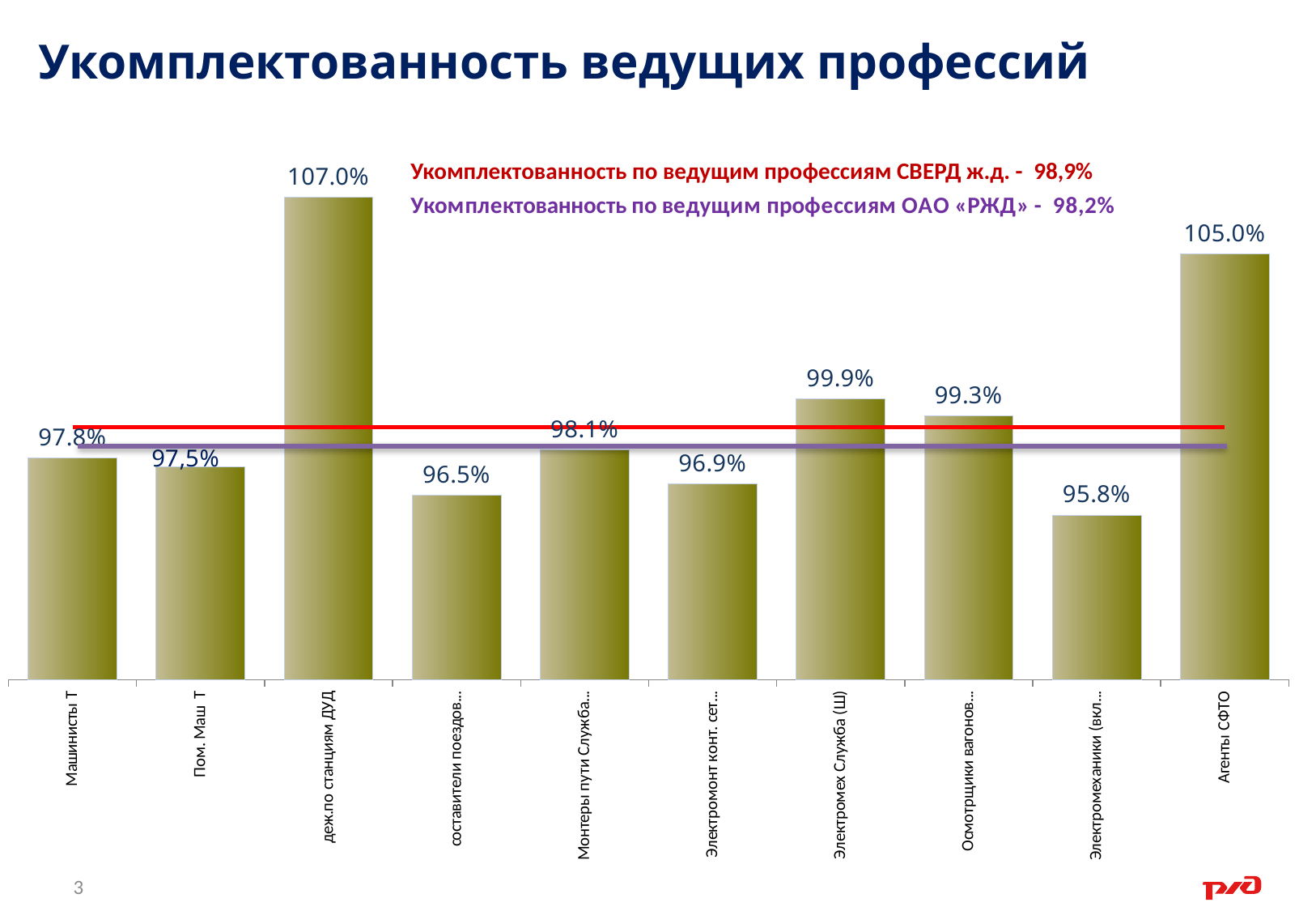
What value does the red horizontal line (Укомплектованность по ведущим профессиям СВЕРД ж.д.) represent? 98,9% What is the value for Агенты СФТО? 105.0% What is the difference between the values for деж.по станциям ДУД and Агенты СФТО? 2.0% What is the value for деж.по станциям ДУД? 107.0% What is the value for Машинисты Т? 97.8% Which is larger, the value for Машинисты Т or the value for Пом. Маш Т? Машинисты Т What type of chart is shown on the slide? bar chart What value does the purple horizontal line (Укомплектованность по ведущим профессиям ОАО «РЖД») represent? 98,2% Which category has the highest value? деж.по станциям ДУД How many categories (bars) are plotted in the chart? 10 Which category has the lowest value? Электромеханики (вкл...) What is the value for Электромех Служба (Ш)? 99.9%